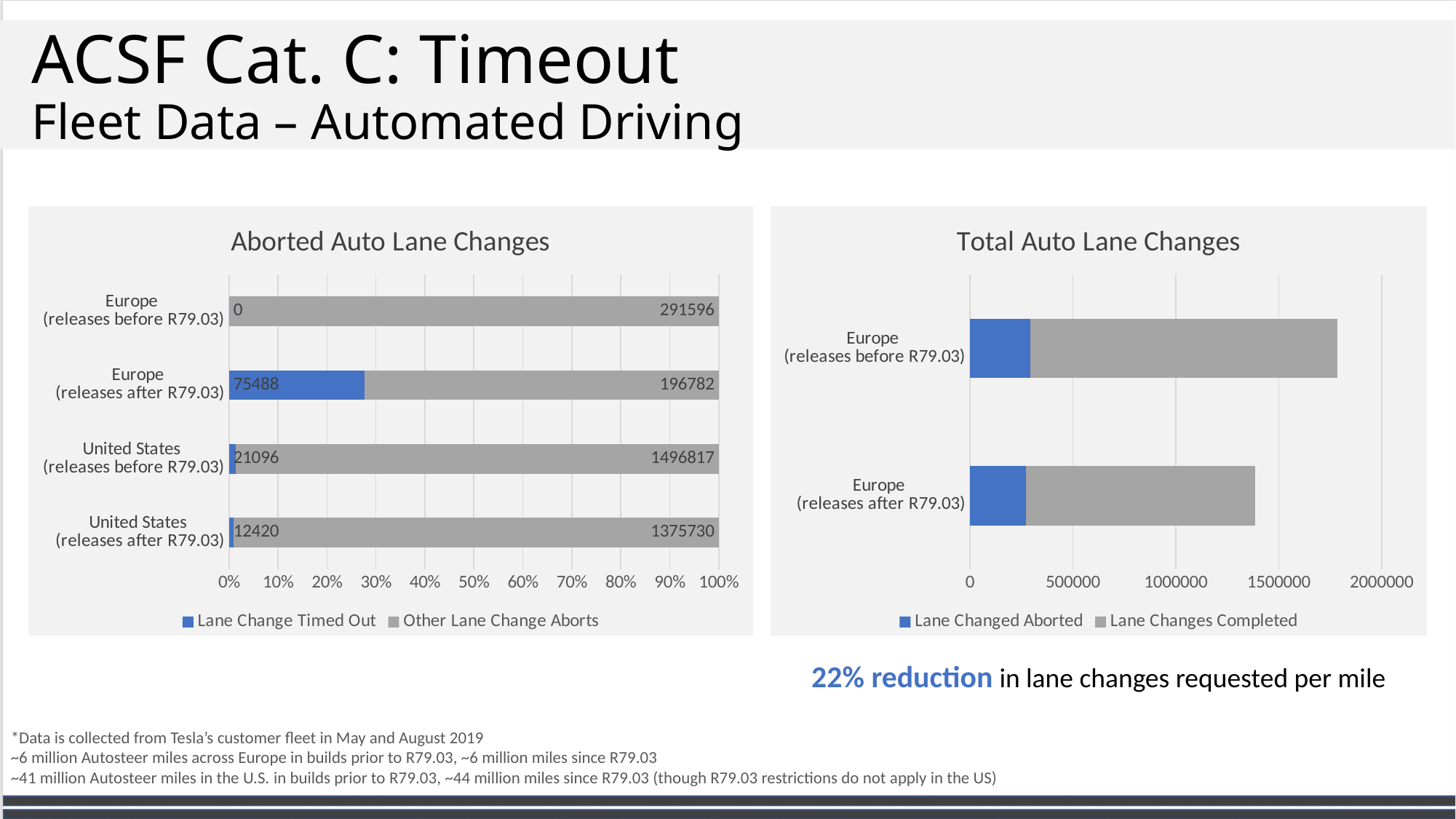
In the 'Aborted Auto Lane Changes' chart, what is the total of the two segments for Europe (releases after R79.03)? 272270 In the 'Aborted Auto Lane Changes' chart, what is the Lane Change Timed Out value for Europe (releases after R79.03)? 75488 In the 'Aborted Auto Lane Changes' chart, which category has the highest Other Lane Change Aborts value? United States (releases before R79.03) In the 'Aborted Auto Lane Changes' chart, what is the Lane Change Timed Out value for Europe (releases before R79.03)? 0 In the 'Aborted Auto Lane Changes' chart, which has the larger Other Lane Change Aborts value: Europe (releases before R79.03) or Europe (releases after R79.03)? Europe (releases before R79.03) In the 'Aborted Auto Lane Changes' chart, what is the difference between the Lane Change Timed Out values for United States (releases before R79.03) and United States (releases after R79.03)? 8676 How many series does the legend of the 'Total Auto Lane Changes' chart list? 2 What kind of chart is the 'Total Auto Lane Changes' chart? bar chart How many categories are shown in the 'Aborted Auto Lane Changes' chart? 4 In the 'Total Auto Lane Changes' chart, is the total bar length for Europe (releases after R79.03) greater or less than 1500000? less In the 'Aborted Auto Lane Changes' chart, which category has the lowest Lane Change Timed Out value? Europe (releases before R79.03) In the 'Aborted Auto Lane Changes' chart, what is the Other Lane Change Aborts value for United States (releases before R79.03)? 1496817